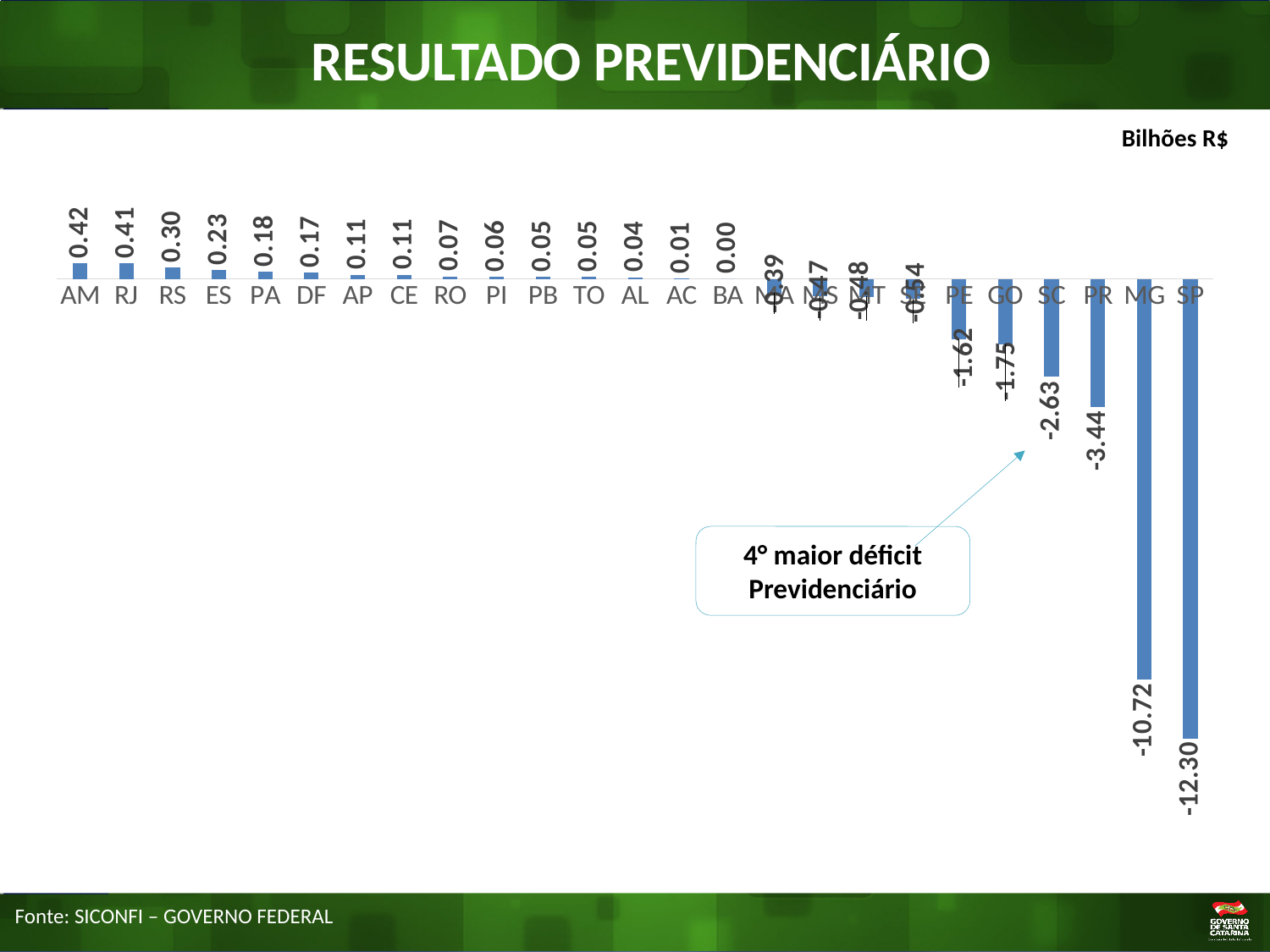
What is the difference between the values for MG and SP? 1.58 What kind of chart is shown on the slide? Bar chart In what unit are the values on the chart expressed? Bilhões R$ What is the value for SC? -2.63 What is the difference between the values for AM and RJ? 0.01 What is the value for PR? -3.44 Which has the larger value, PE or GO? PE Which state has the highest value? AM What is the value for MG? -10.72 What is the value for SP? -12.30 What is the value for AM? 0.42 Which state has the lowest value? SP